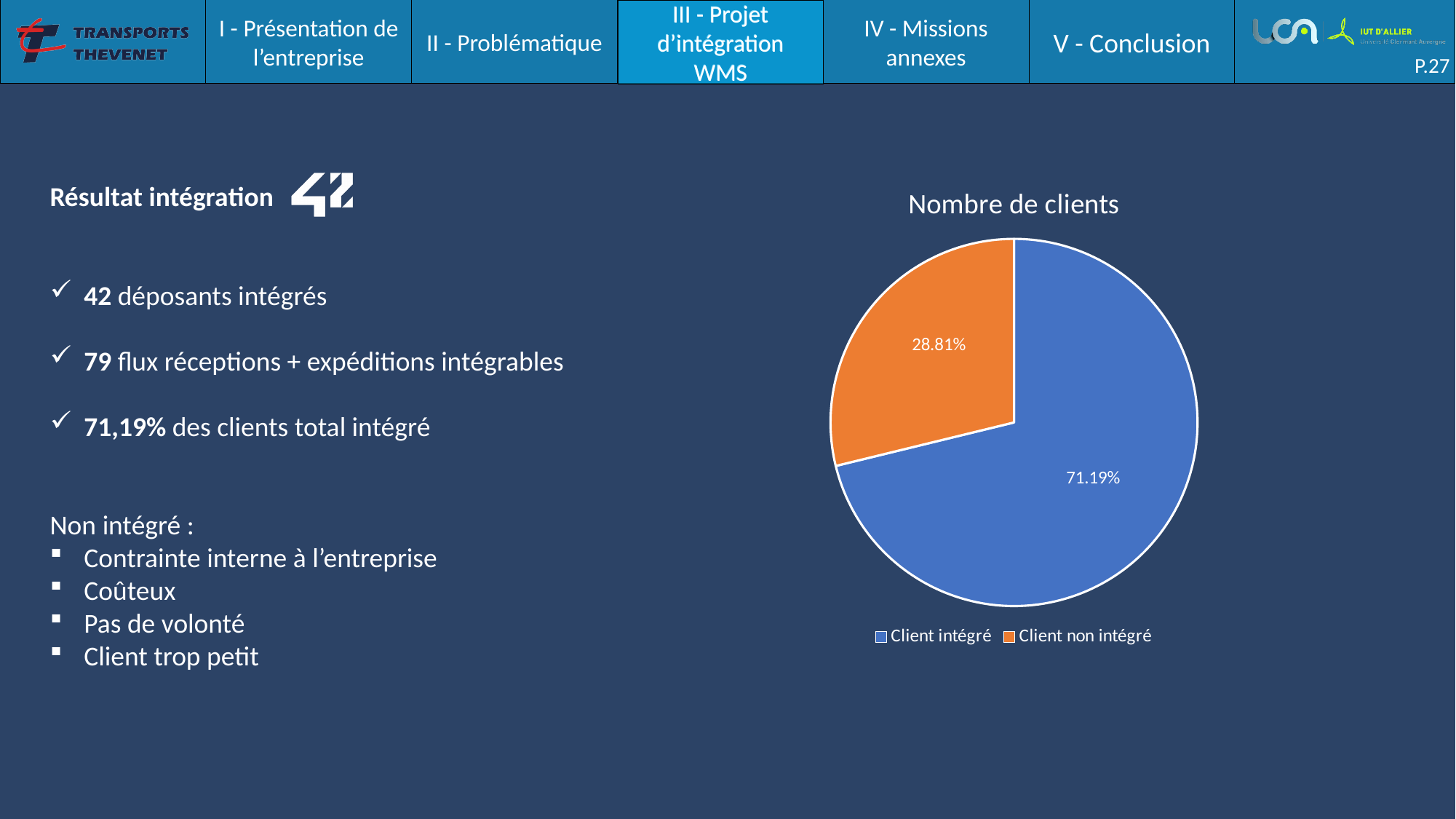
What share of the pie does "Client intégré" represent? 71.19% Which slice of the pie chart is the largest? Client intégré How many slices does the pie chart have? 2 Which is larger, the "Client intégré" slice or the "Client non intégré" slice? Client intégré What is the difference in percentage points between the "Client intégré" and "Client non intégré" slices? 42.38 What type of chart is shown on the slide? pie chart How many entries does the legend of the pie chart list? 2 Which slice of the pie chart is the smallest? Client non intégré What colour is the "Client non intégré" slice in the pie chart? orange What is the title of the pie chart? Nombre de clients What share of the pie does "Client non intégré" represent? 28.81%